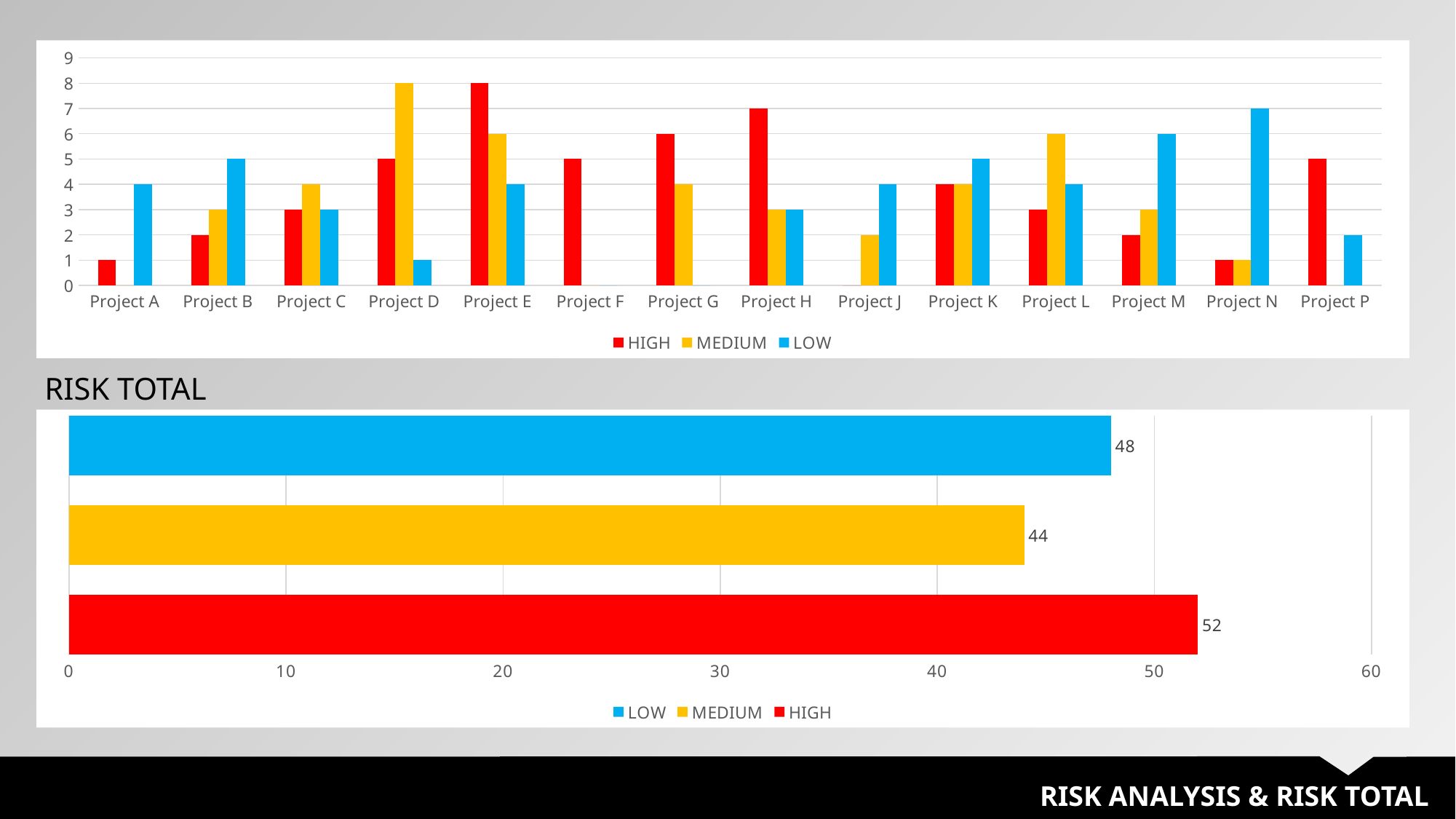
In the top chart, what is the MEDIUM value for Project D? 8 In the top chart, what is the LOW value for Project N? 7 In the RISK TOTAL chart, what is the difference between the HIGH and MEDIUM values? 8 In the RISK TOTAL chart, which category has the highest value? HIGH In the top chart, what is the HIGH value for Project E? 8 In the RISK TOTAL chart, how many series does the legend list? 3 What kind of chart is the RISK TOTAL chart? bar chart In the top chart, which has the larger HIGH value, Project G or Project H? Project H In the RISK TOTAL chart, what is the value for HIGH? 52 In the top chart, how many projects are shown on the x axis? 14 In the RISK TOTAL chart, which category has the lowest value? MEDIUM In the RISK TOTAL chart, what is the value for MEDIUM? 44